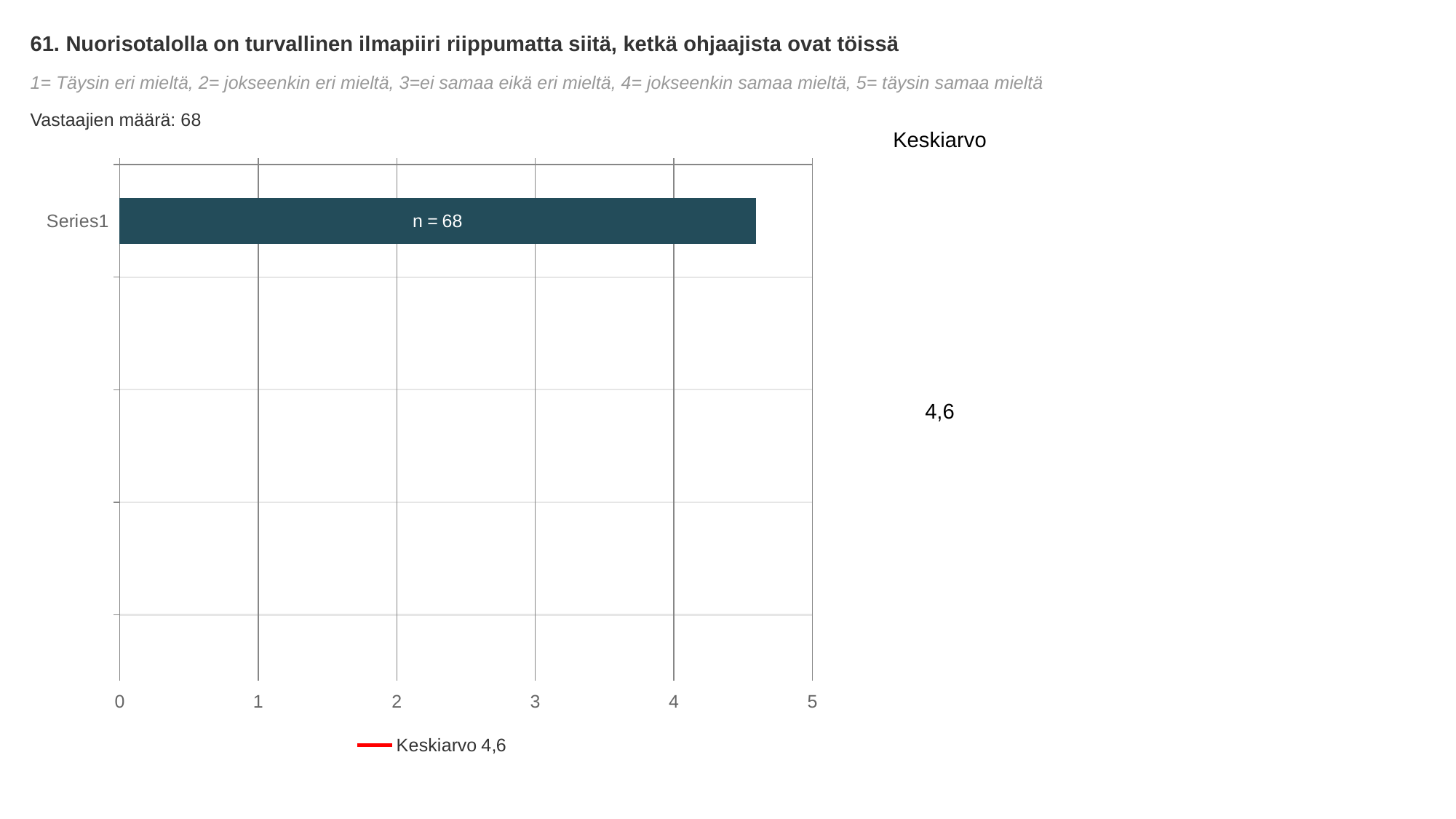
How many entries does the legend list? 1 How many bars are plotted in the chart? 1 What kind of chart is shown on the slide? bar chart What is the number of respondents (Vastaajien määrä) stated on the slide? 68 Is the value of the Series1 bar greater or less than 4? greater What is the Keskiarvo (mean) value shown on the slide? 4,6 What is the data label printed on the Series1 bar? n = 68 What is the highest tick value shown on the horizontal axis? 5 What is the legend entry text below the chart? Keskiarvo 4,6 Is the value of the Series1 bar greater or less than 5? less What is the category label of the single bar in the chart? Series1